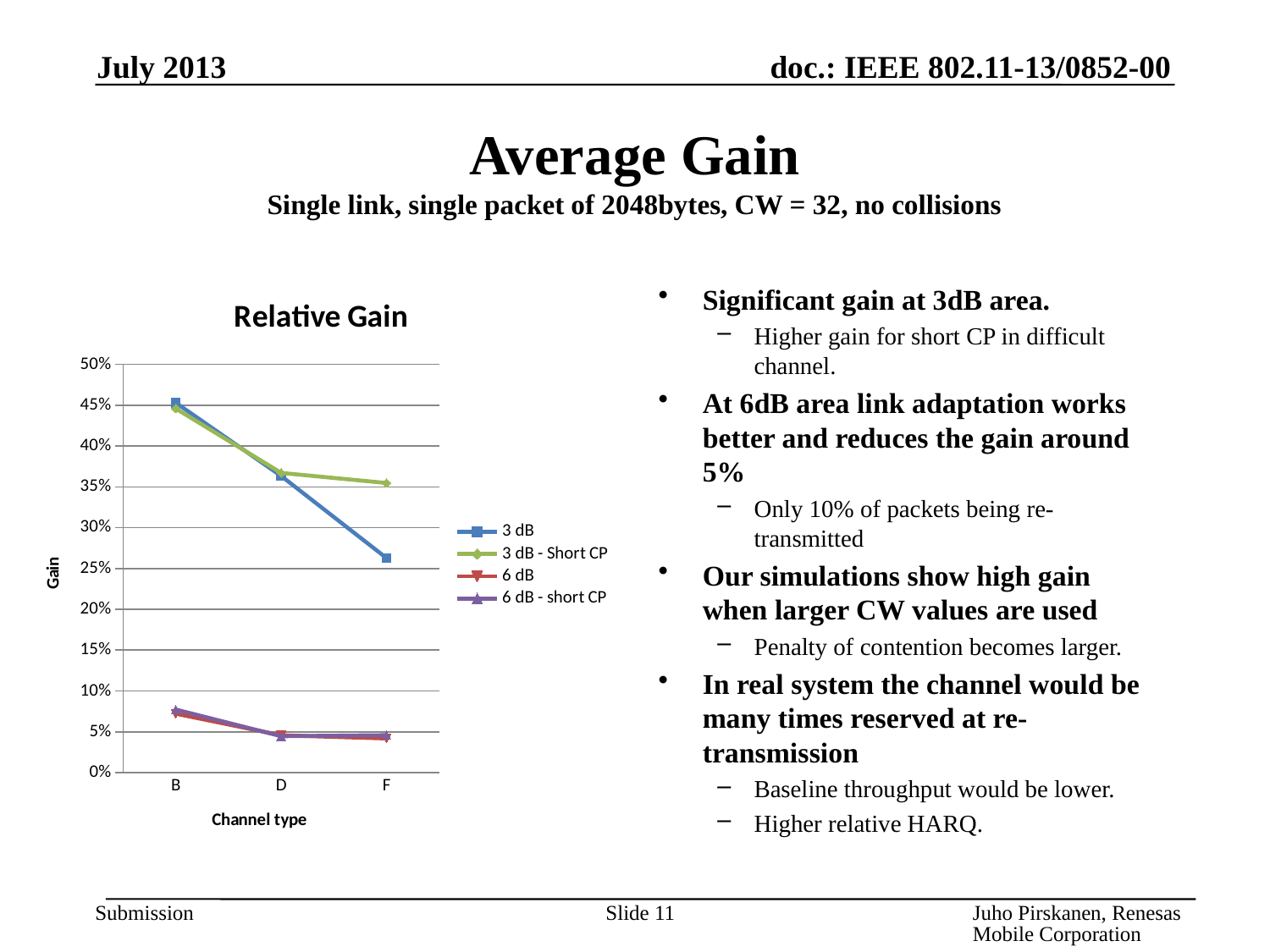
In the Relative Gain chart, at channel type F, which is larger: the 3 dB series or the 3 dB - Short CP series? 3 dB - Short CP How many channel types are shown on the x axis of the Relative Gain chart? 3 In the Relative Gain chart, is the value for the 3 dB series at channel type F greater or less than 30%? less In the Relative Gain chart, is the value for the 6 dB series at channel type B greater or less than 10%? less In the Relative Gain chart, at channel type B, which is larger: the 3 dB series or the 6 dB series? 3 dB In the Relative Gain chart, is the value for the 3 dB series at channel type B greater or less than 40%? greater In the Relative Gain chart, does the 3 dB series rise or fall from channel type B to F? fall In the Relative Gain chart, which channel type has the highest value for the 3 dB series? B How many series does the legend of the Relative Gain chart list? 4 What kind of chart is the Relative Gain chart? line chart What is the x-axis title of the Relative Gain chart? Channel type